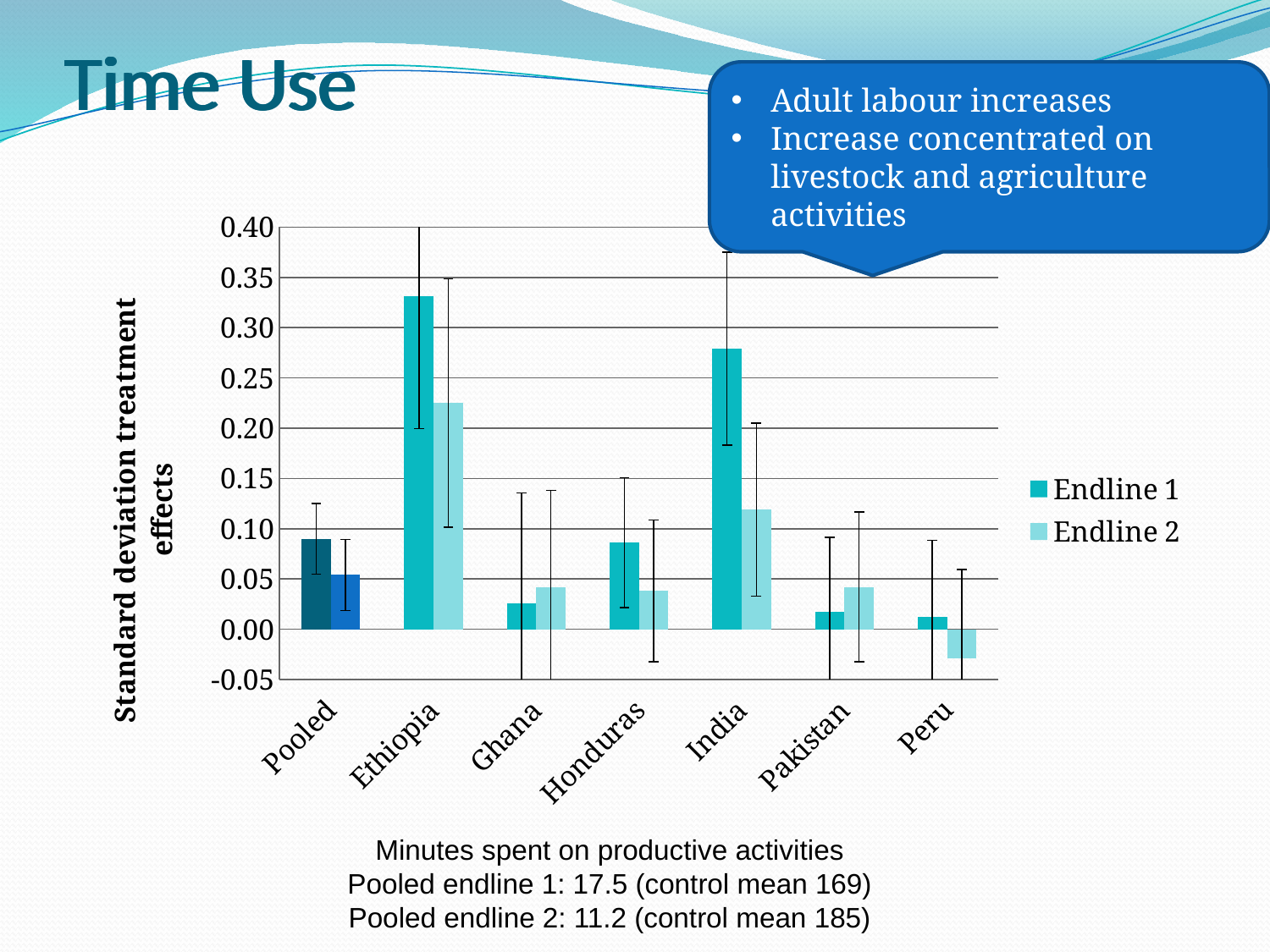
Which category has the lowest Endline 2 value? Peru What kind of chart is shown on the slide? bar chart Which category has the highest Endline 1 value? Ethiopia Which is larger for India: the Endline 1 value or the Endline 2 value? Endline 1 What is the title of the chart's vertical axis? Standard deviation treatment effects Is the Endline 2 value for Peru greater or less than 0.00? less How many series does the chart legend list? 2 Which category has the larger Endline 1 value: Ethiopia or India? Ethiopia Is the Endline 1 value for Ethiopia greater or less than 0.30? greater How many categories are shown on the x axis of the chart? 7 Which category has the highest Endline 2 value? Ethiopia Is the Endline 1 value for India greater or less than 0.25? greater